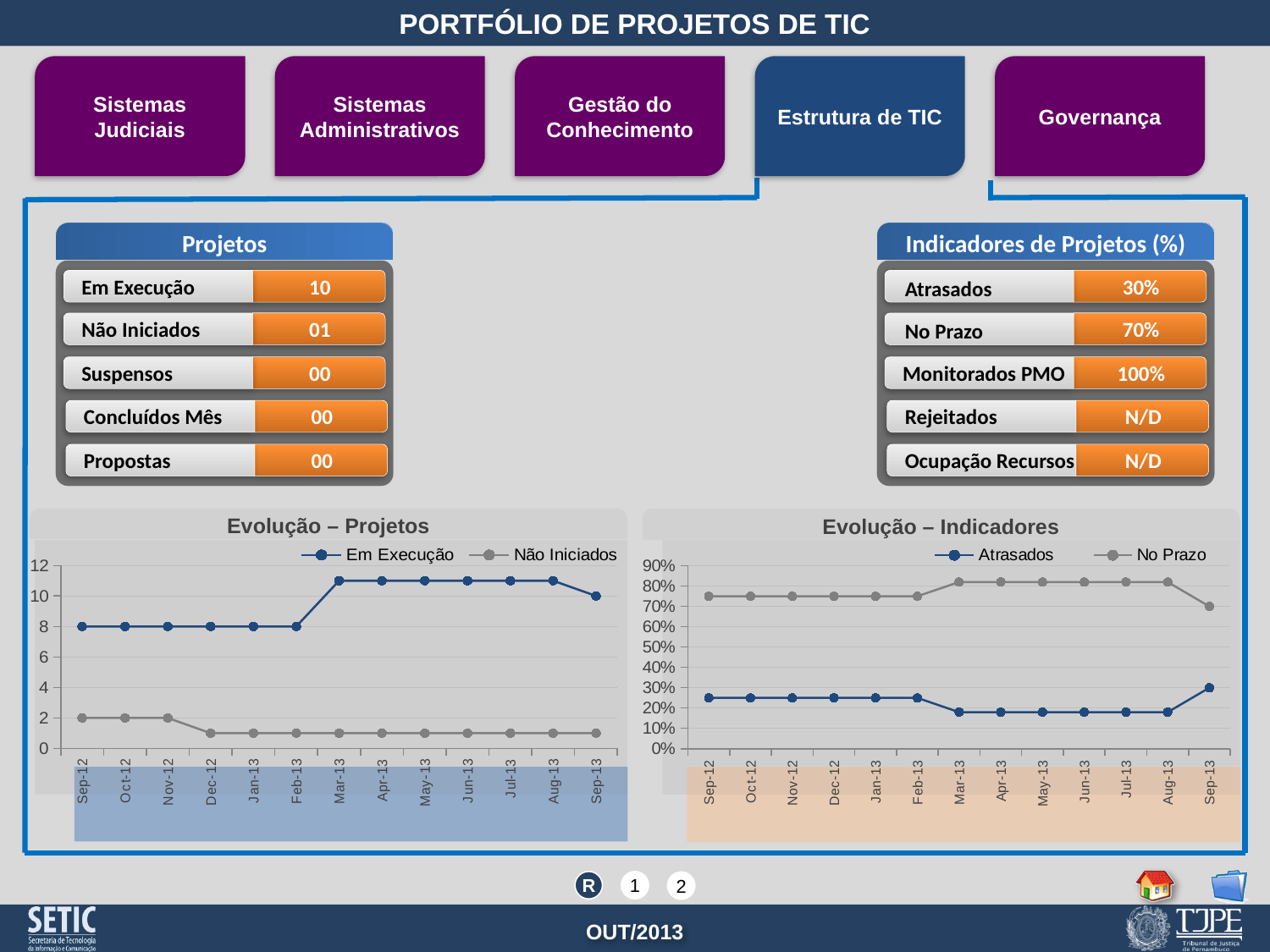
In 'Evolução – Indicadores', what is the value of Atrasados in Sep-13? 30% In 'Evolução – Indicadores', which series is higher in Jan-13, Atrasados or No Prazo? No Prazo In 'Evolução – Projetos', does the Não Iniciados series rise or fall from Sep-12 to Sep-13? fall In 'Evolução – Projetos', what is the value of Em Execução in Sep-13? 10 How many series does the legend of 'Evolução – Indicadores' list? 2 What kind of chart is 'Evolução – Projetos'? line chart In 'Evolução – Indicadores', what is the value of No Prazo in Sep-13? 70% In 'Evolução – Projetos', what is the value of Não Iniciados in Oct-12? 2 In 'Evolução – Projetos', is the value for Em Execução in May-13 greater or less than 10? greater How many months are plotted along the x axis of 'Evolução – Projetos'? 13 In 'Evolução – Projetos', what is the value of Em Execução in Sep-12? 8